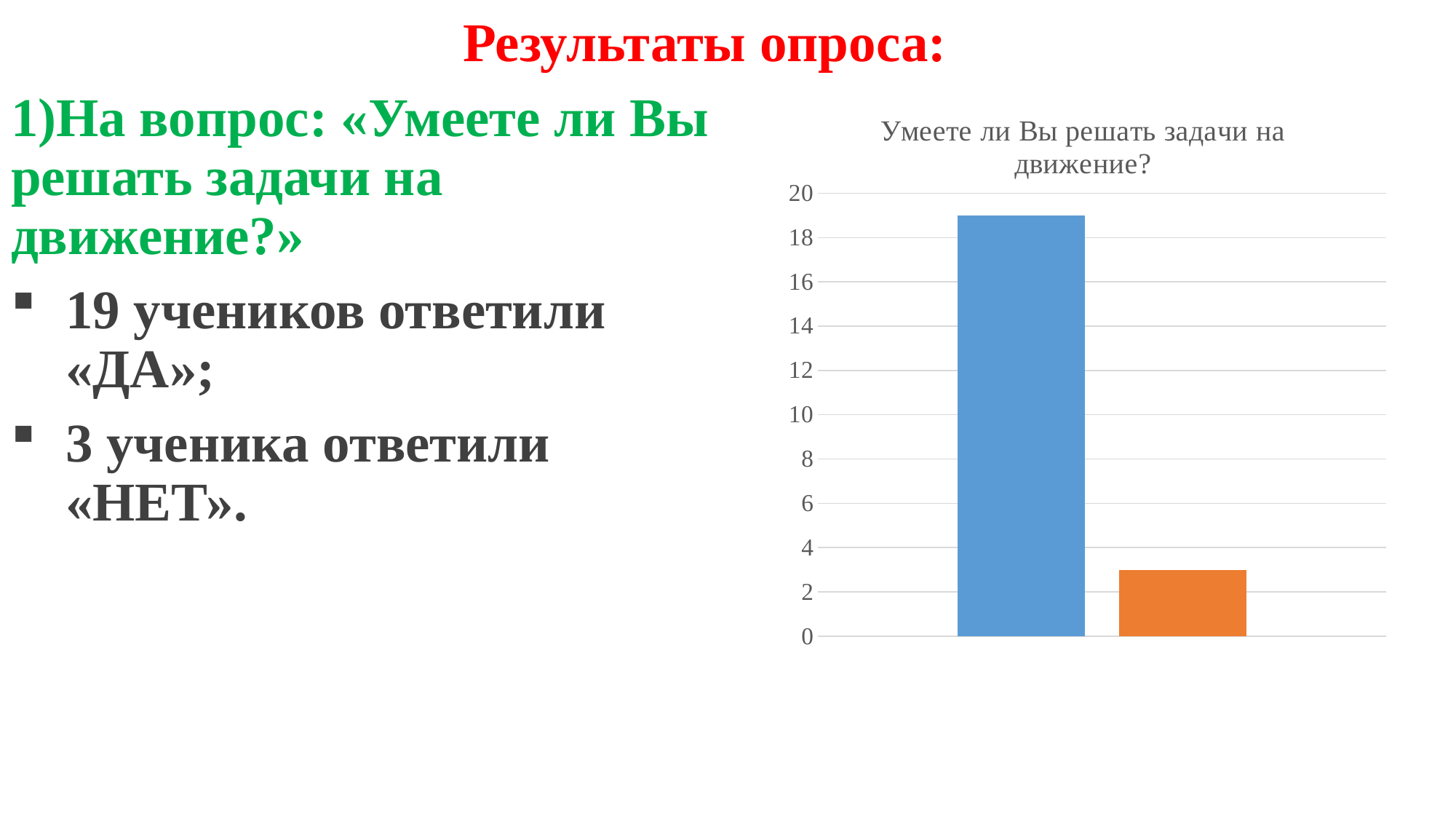
Is the value of the blue bar greater or less than 18? greater What kind of chart is shown on the slide? bar chart How many bars are plotted in the chart? 2 Which bar is taller, the blue bar on the left or the orange bar on the right? the blue bar on the left What is the highest value shown on the vertical axis of the chart? 20 Is the value of the orange bar greater or less than 4? less Is the value of the orange bar greater or less than 2? greater Which bar has the highest value in the chart? the blue bar on the left Which bar has the lowest value in the chart? the orange bar on the right What is the title of the chart? Умеете ли Вы решать задачи на движение?